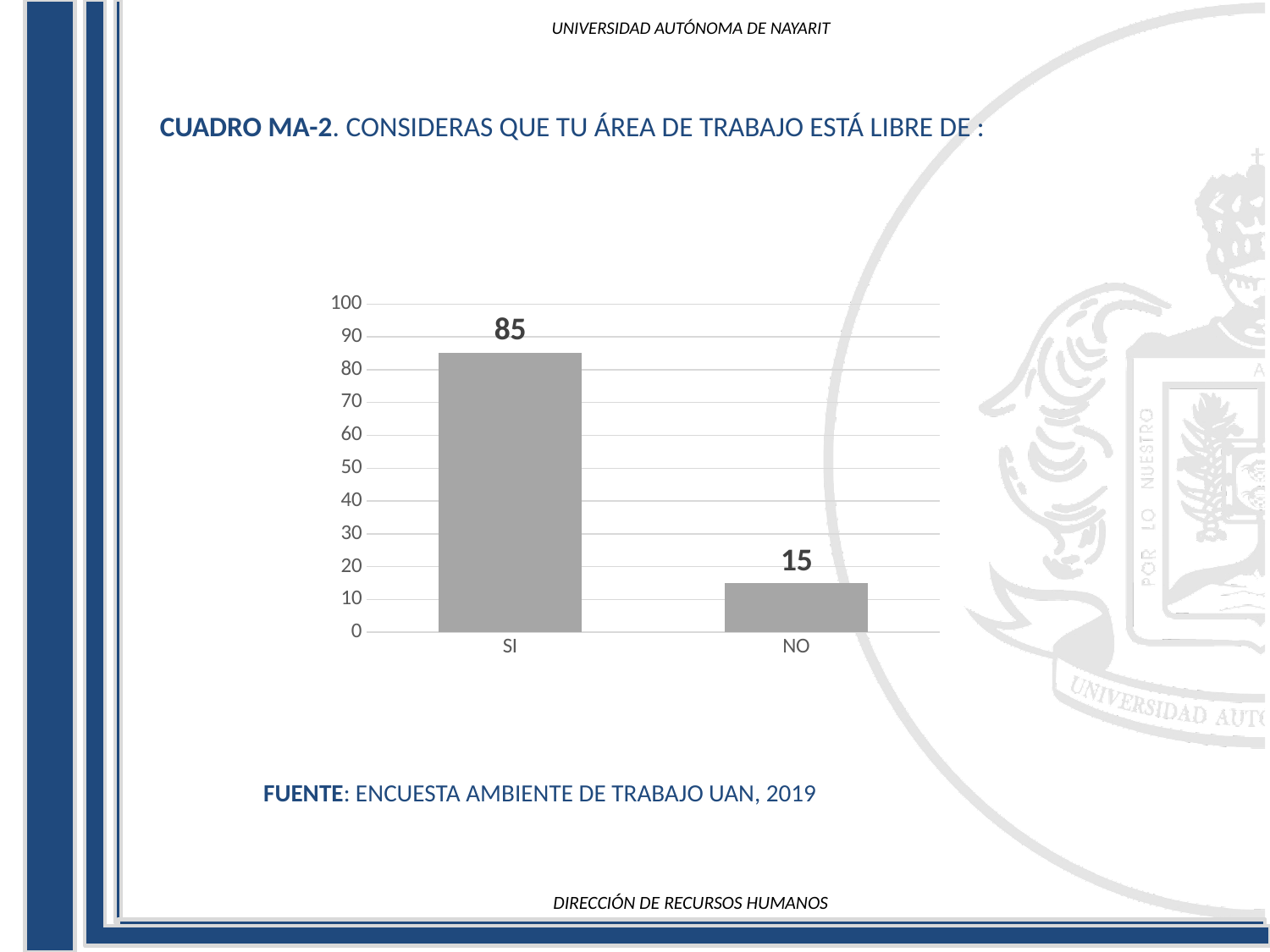
What is the value for NO? 15 What is the maximum value shown on the vertical axis? 100 Is the value for SI greater or less than 80? greater Which is larger, the value for SI or the value for NO? SI What is the value for SI? 85 How many categories are shown on the x axis? 2 Which category has the lowest value? NO What kind of chart is shown on the slide? bar chart What is the difference between the values for SI and NO? 70 Is the value for NO greater or less than 20? less Which category has the highest value? SI What is the total of the values for SI and NO? 100